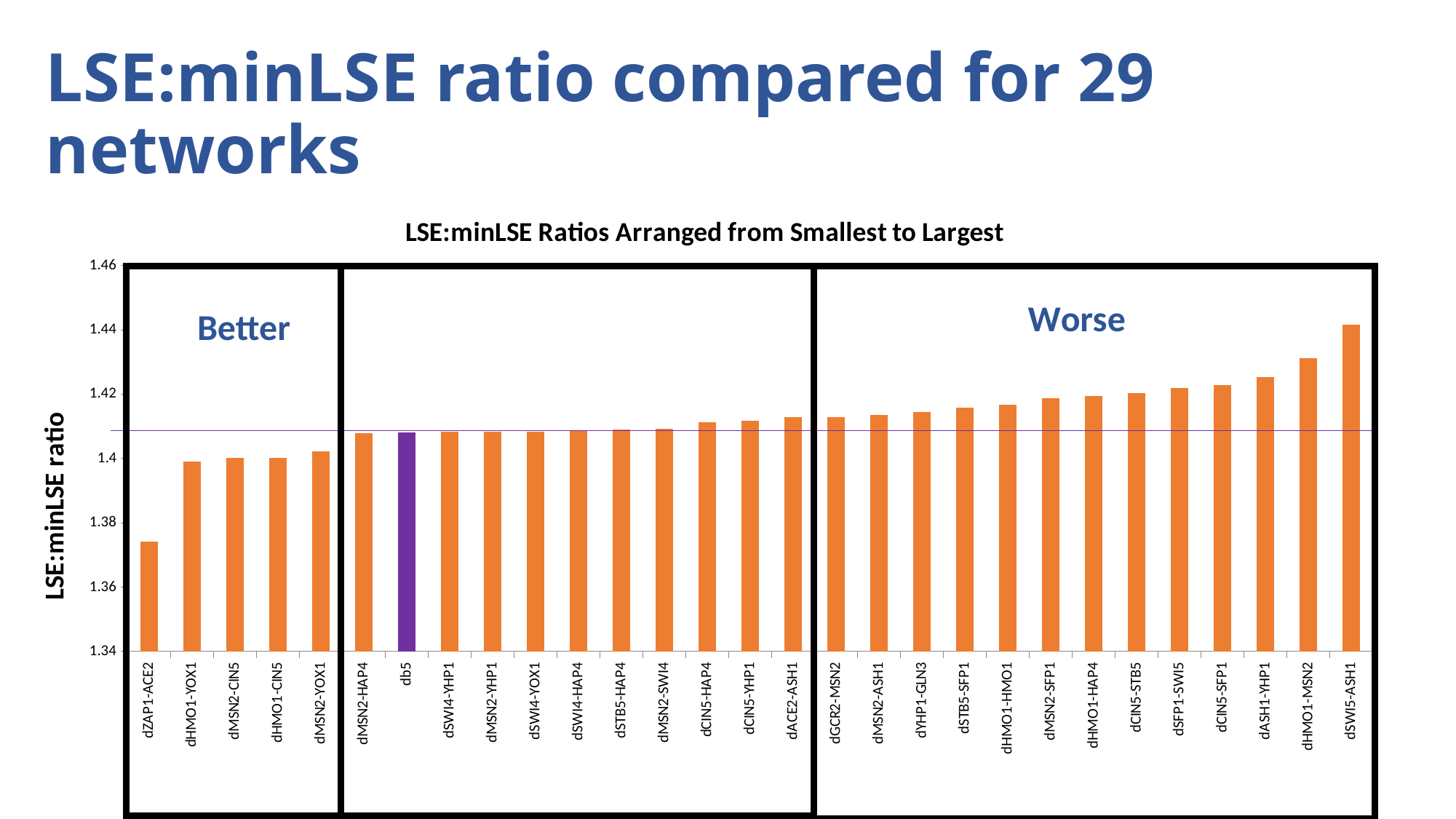
Which has a larger LSE:minLSE ratio, dHMO1-MSN2 or db5? dHMO1-MSN2 Is the LSE:minLSE ratio for dACE2-ASH1 greater or less than 1.40? greater Which network has the lowest LSE:minLSE ratio? dZAP1-ACE2 Do the LSE:minLSE ratios rise or fall from left to right along the x axis? rise Is the LSE:minLSE ratio for dHMO1-MSN2 greater or less than 1.42? greater What is the title of the chart? LSE:minLSE Ratios Arranged from Smallest to Largest Is the LSE:minLSE ratio for dSWI5-ASH1 greater or less than 1.42? greater How many networks (bars) are plotted in the chart? 29 What kind of chart is shown on the slide? bar chart Which network's bar is coloured purple instead of orange? db5 Which network has the highest LSE:minLSE ratio? dSWI5-ASH1